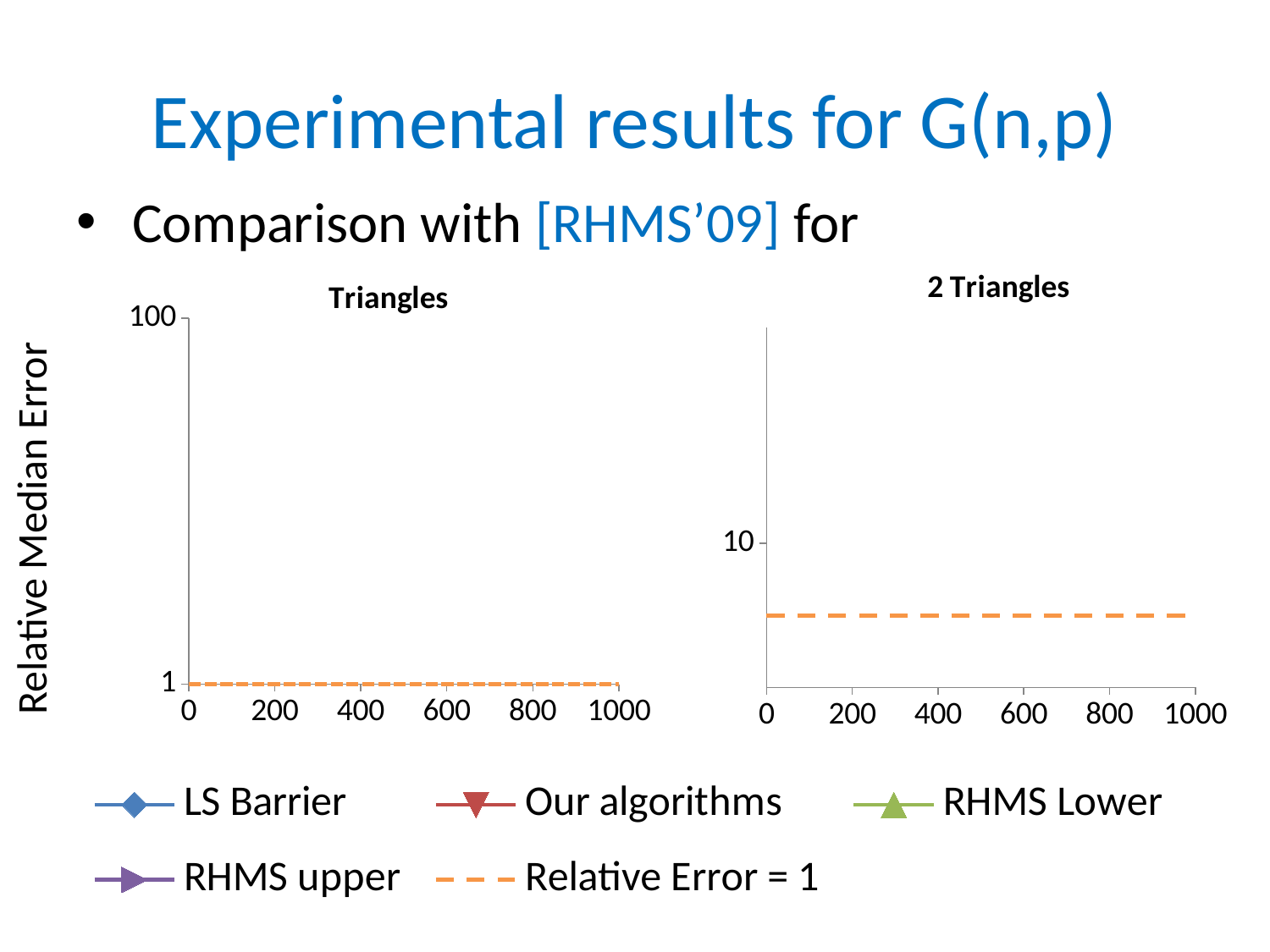
In the "Triangles" chart, at what value does the "Relative Error = 1" dashed line lie on the y axis? 1 What kind of chart is the "Triangles" chart? line chart What is the highest tick shown on the y axis of the "Triangles" chart? 100 How many series does the legend list? 5 In the "2 Triangles" chart, does the "Relative Error = 1" line rise, fall, or stay flat as x increases from 0 to 1000? stay flat In the "2 Triangles" chart, is the "Relative Error = 1" dashed line greater or less than 10? less Which legend entry is drawn as a dashed line? Relative Error = 1 In the "Triangles" chart, does the "Relative Error = 1" line rise, fall, or stay flat along the x axis? stay flat What is the highest tick shown on the x axis of the "Triangles" chart? 1000 What is the title of the chart on the right of the slide? 2 Triangles